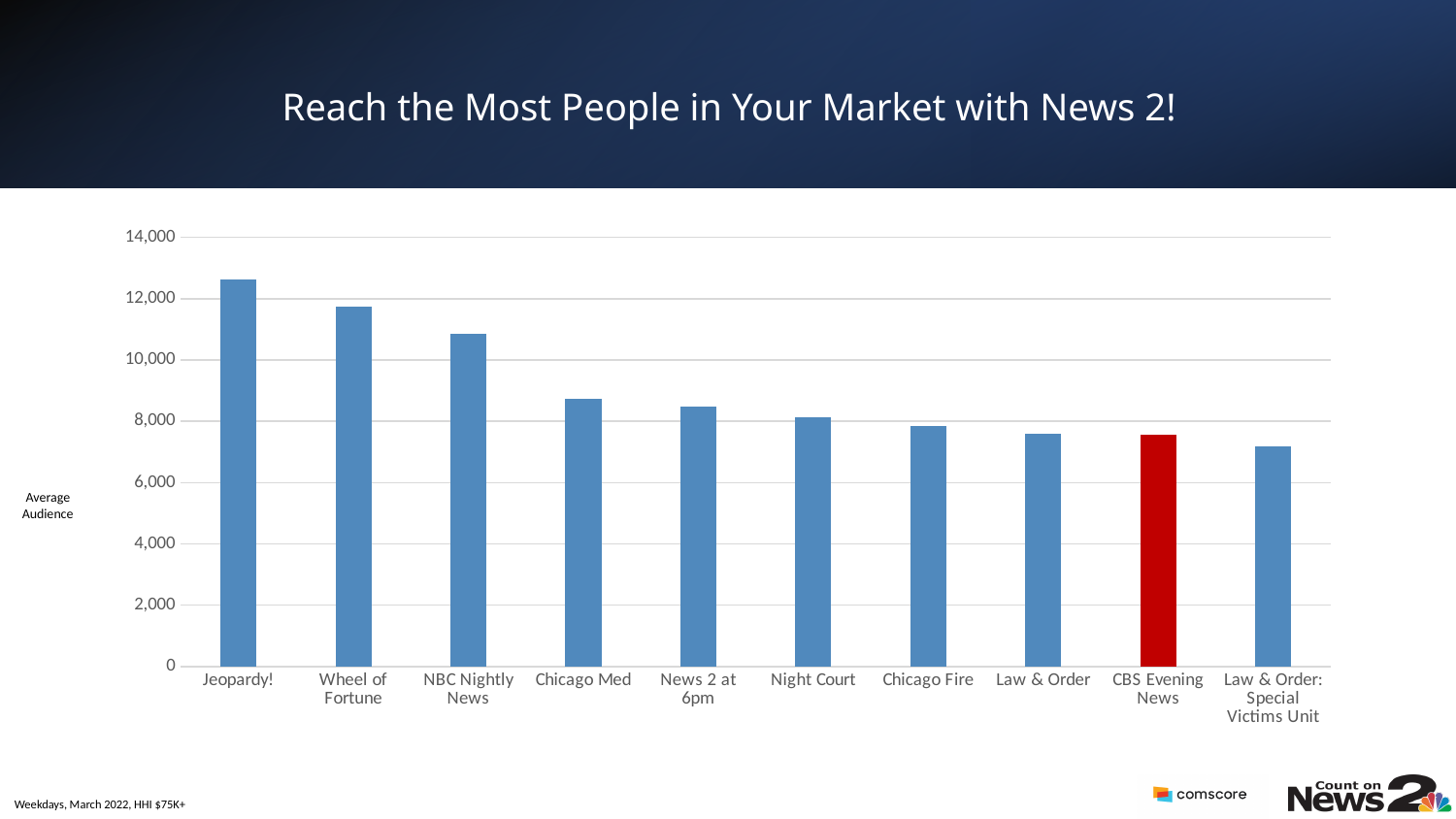
Which has a larger average audience, NBC Nightly News or Chicago Med? NBC Nightly News Is the value for Jeopardy! greater or less than 12,000? greater How many programs are shown on the x axis of the chart? 10 Is the value for Wheel of Fortune greater or less than 12,000? less Do the values rise or fall moving from left to right along the x axis? fall Which program has the highest average audience in the chart? Jeopardy! What kind of chart is shown on the slide? Bar chart Is the value for Law & Order: Special Victims Unit greater or less than 8,000? less Which program's bar is coloured red in the chart? CBS Evening News Which program has the lowest average audience in the chart? Law & Order: Special Victims Unit